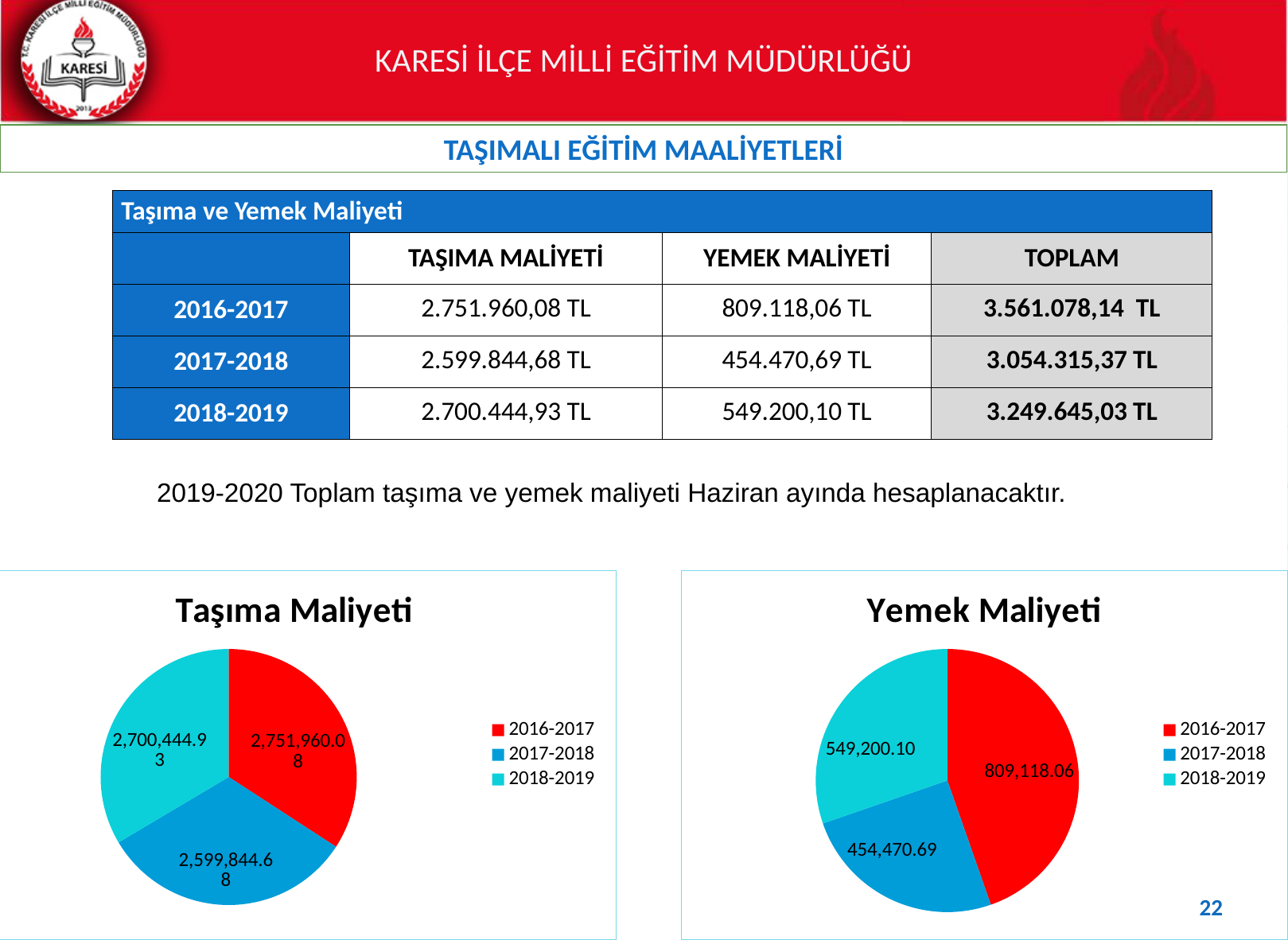
In the "Taşıma Maliyeti" chart, what is the difference between the 2016-2017 and 2017-2018 values? 152,115.40 In the "Taşıma Maliyeti" chart, what is the value for 2016-2017? 2,751,960.08 In the "Yemek Maliyeti" chart, which colour represents 2018-2019 in the legend? Cyan (light blue) In the "Yemek Maliyeti" chart, which year has the largest slice? 2016-2017 In the "Yemek Maliyeti" chart, which year has the smallest slice? 2017-2018 In the "Yemek Maliyeti" chart, which is larger: the value for 2017-2018 or 2018-2019? 2018-2019 In the "Taşıma Maliyeti" chart, what is the value for 2017-2018? 2,599,844.68 What type of chart is the "Taşıma Maliyeti" chart? Pie chart How many slices does the "Taşıma Maliyeti" pie chart have? 3 In the "Taşıma Maliyeti" chart, which year has the smallest slice? 2017-2018 In the "Yemek Maliyeti" chart, what is the value for 2018-2019? 549,200.10 In the "Yemek Maliyeti" chart, what is the difference between the 2016-2017 and 2017-2018 values? 354,647.37